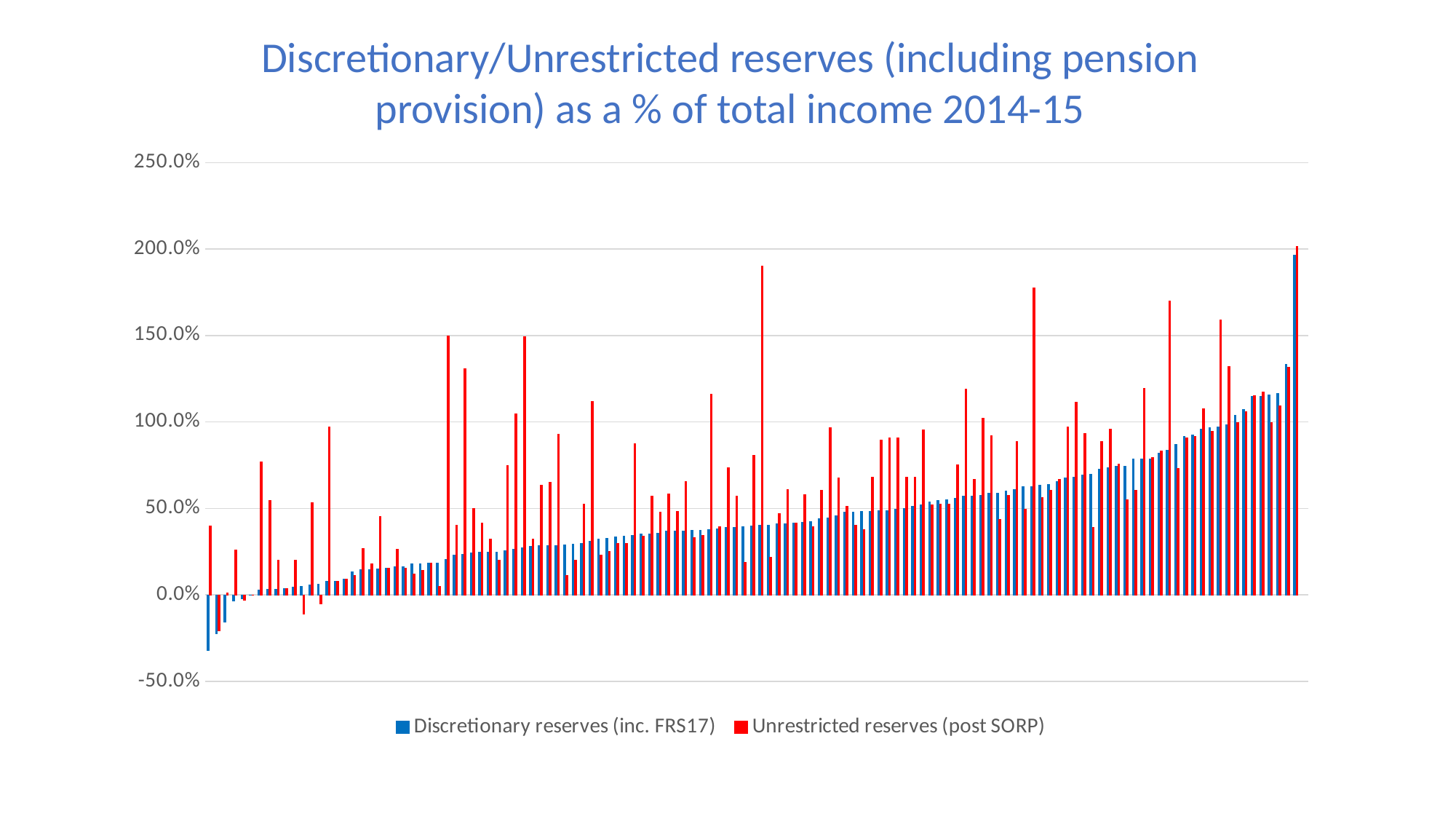
What kind of chart is shown on the slide? Bar chart Is the tallest red Unrestricted reserves (post SORP) bar greater or less than 150.0%? greater Is the leftmost blue Discretionary reserves (inc. FRS17) bar greater or less than 0.0%? less Which series is shown in red in the legend? Unrestricted reserves (post SORP) Is the lowest value on the vertical axis greater or less than 0.0%? less Do the blue Discretionary reserves (inc. FRS17) bars generally rise or fall from left to right along the x axis? Rise Which series has the tallest bar on the chart, Discretionary reserves (inc. FRS17) or Unrestricted reserves (post SORP)? Unrestricted reserves (post SORP) What is the highest value shown on the vertical axis? 250.0% What is the title of the chart? Discretionary/Unrestricted reserves (including pension provision) as a % of total income 2014-15 How many series does the legend list? 2